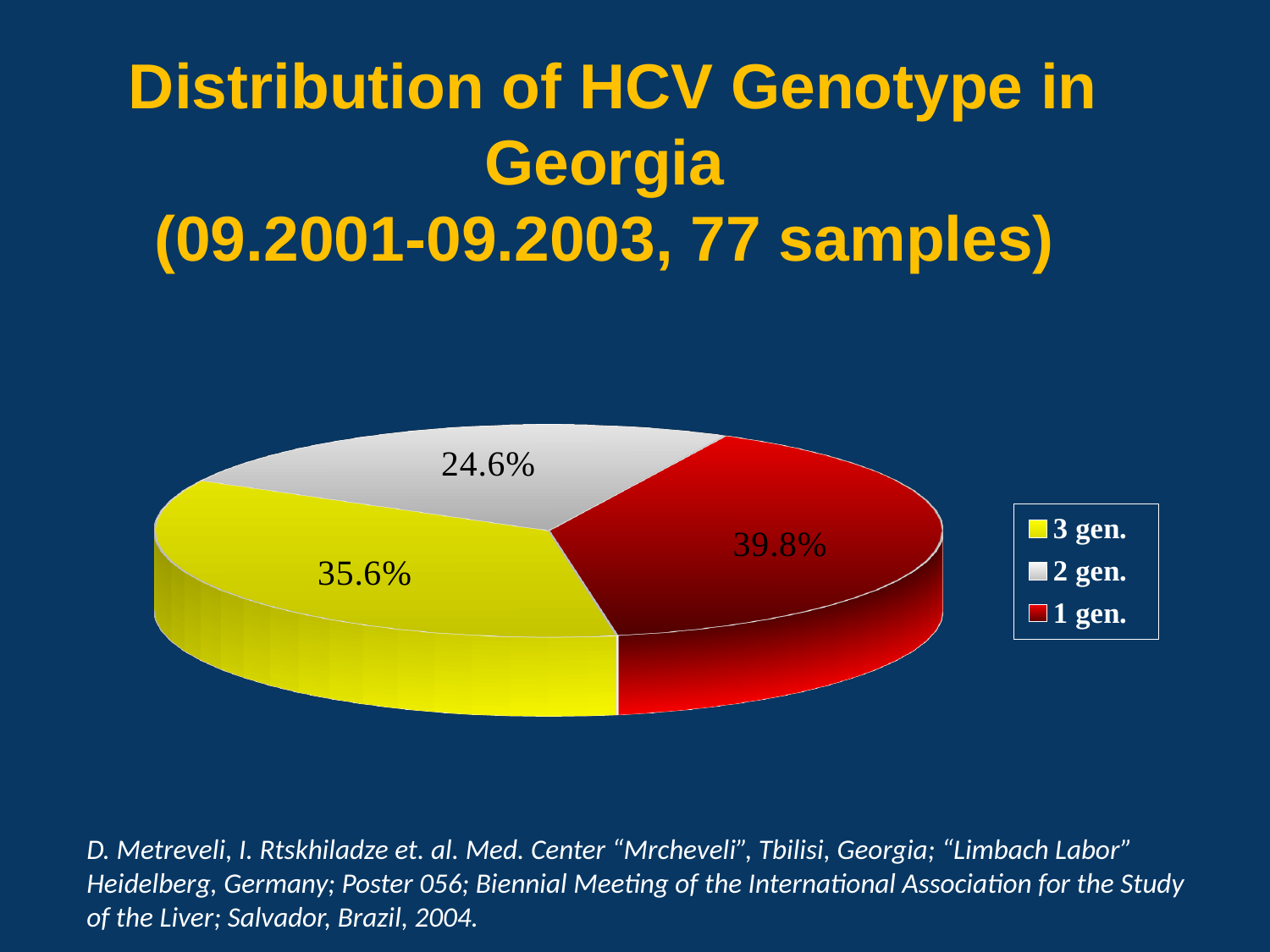
Which genotype has the largest slice of the pie? 1 gen. What kind of chart is shown on the slide? Pie chart Which slice is larger, 3 gen. or 2 gen.? 3 gen. What share of the pie does 2 gen. have? 24.6% What is the difference in percentage points between the 1 gen. and 3 gen. slices? 4.2 What is the difference in percentage points between the 1 gen. and 2 gen. slices? 15.2 What share of the pie does 3 gen. have? 35.6% What share of the pie does 1 gen. have? 39.8% How many entries does the legend list? 3 What colour is the 1 gen. slice? Red How many slices does the pie chart have? 3 Which genotype has the smallest slice of the pie? 2 gen.